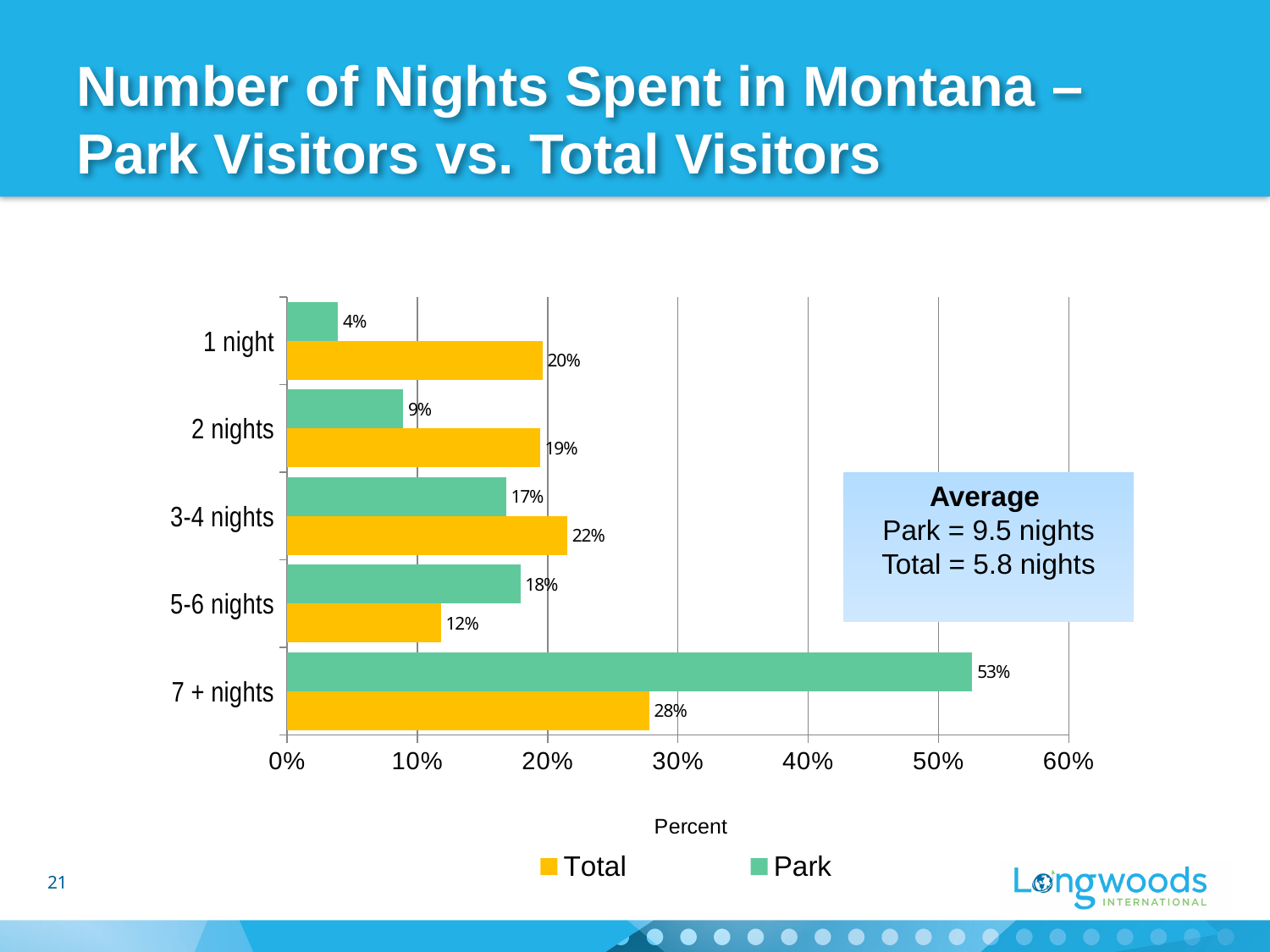
For 1 night, which is larger, the Total value or the Park value? Total What is the Park value for 5-6 nights? 18% Is the Park value for 7 + nights greater or less than 50%? greater Which category has the highest Park value? 7 + nights How many night categories are shown on the chart? 5 What is the difference between the Park and Total values for 7 + nights? 25% What kind of chart is shown on the slide? Bar chart Which category has the lowest Park value? 1 night How many series does the legend list? 2 What percentage of Park visitors spent 7 + nights in Montana? 53% Which category has the lowest Total value? 5-6 nights What percentage of Total visitors spent 1 night in Montana? 20%